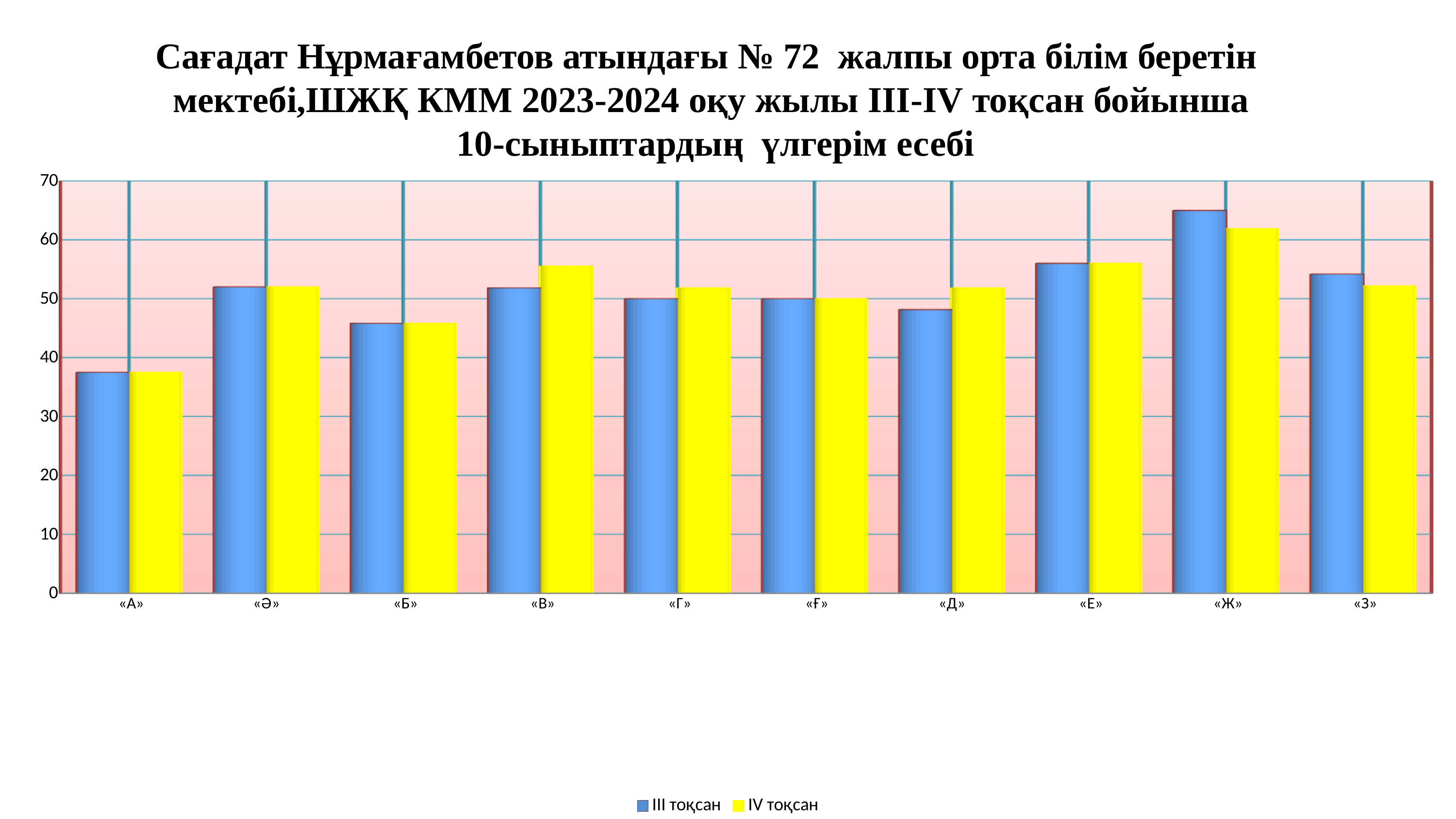
Which category has the highest value for III тоқсан? «Ж» Is the III тоқсан value for «Ж» greater or less than 60? greater Is the III тоқсан value for «А» greater or less than 40? less For «В», which is larger: the III тоқсан value or the IV тоқсан value? IV тоқсан How many series does the legend list? 2 How many class categories are shown on the x axis? 10 Which category has the lowest value for III тоқсан? «А» Which category has the highest value for IV тоқсан? «Ж» Which colour represents IV тоқсан in the legend? yellow Is the IV тоқсан value for «Б» greater or less than 50? less What kind of chart is shown on the slide? bar chart Which category has the lowest value for IV тоқсан? «А»